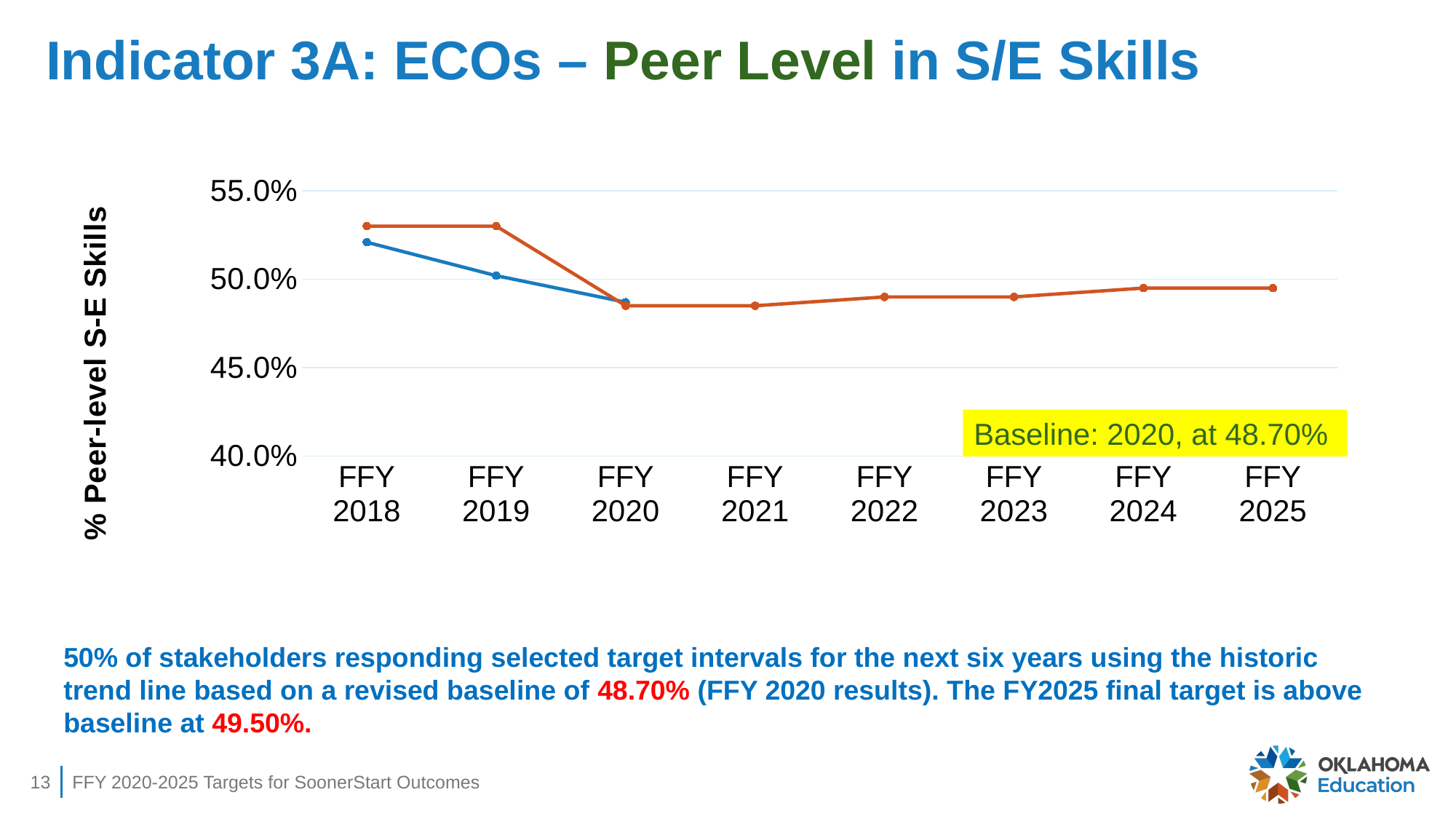
Is the value of the orange line for FFY 2021 greater or less than 50.0%? less What kind of chart is shown on the slide? line chart What is the baseline value for 2020 shown on the chart? 48.70% What is the title of the y axis? % Peer-level S-E Skills At which FFY does the blue line reach its lowest value? FFY 2020 Does the orange line rise or fall from FFY 2019 to FFY 2020? fall Is the value of the orange line for FFY 2018 greater or less than 50.0%? greater How many FFY categories are shown on the x axis? 8 What is the FY2025 final target value stated on the slide? 49.50% Is the value of the orange line for FFY 2024 greater or less than 45.0%? greater How many lines are plotted on the chart? 2 Which is larger on the blue line: the value for FFY 2018 or the value for FFY 2020? FFY 2018